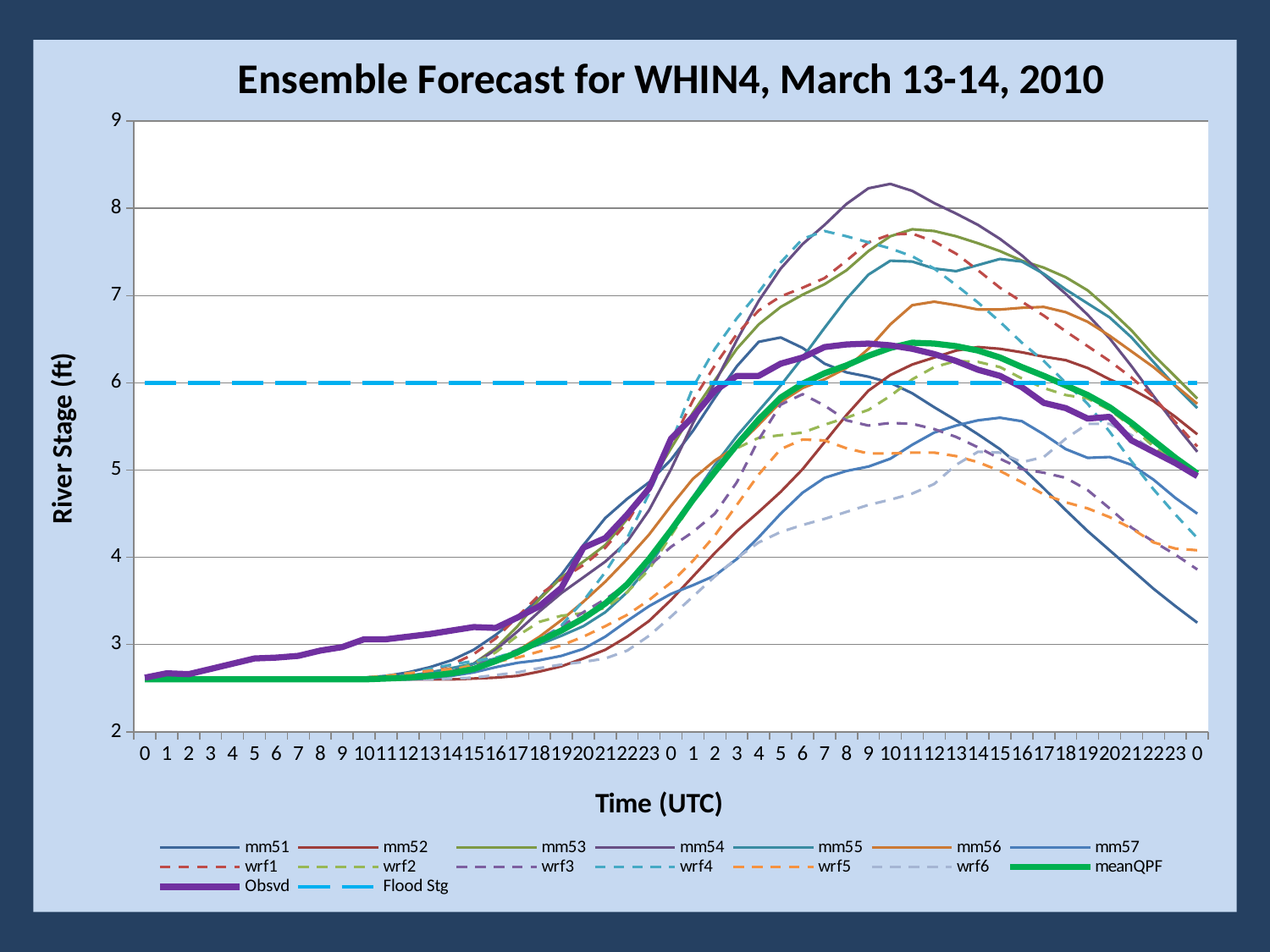
Does the Obsvd series rise or fall between hour 0 of the first day and hour 9 of the second day? rise Is the peak value of the Obsvd series greater or less than 7? less Is the value of the mm51 series at the final hour greater or less than 4? less What is the title of the chart? Ensemble Forecast for WHIN4, March 13-14, 2010 What is the label of the vertical axis? River Stage (ft) Is the peak value of the mm54 series greater or less than 8? greater At what river stage is the Flood Stg line drawn? 6 How many series does the legend list? 16 Which series reaches the highest peak river stage? mm54 Which series has the lowest value at the final hour on the x axis? mm51 What kind of chart is shown on the slide? line chart